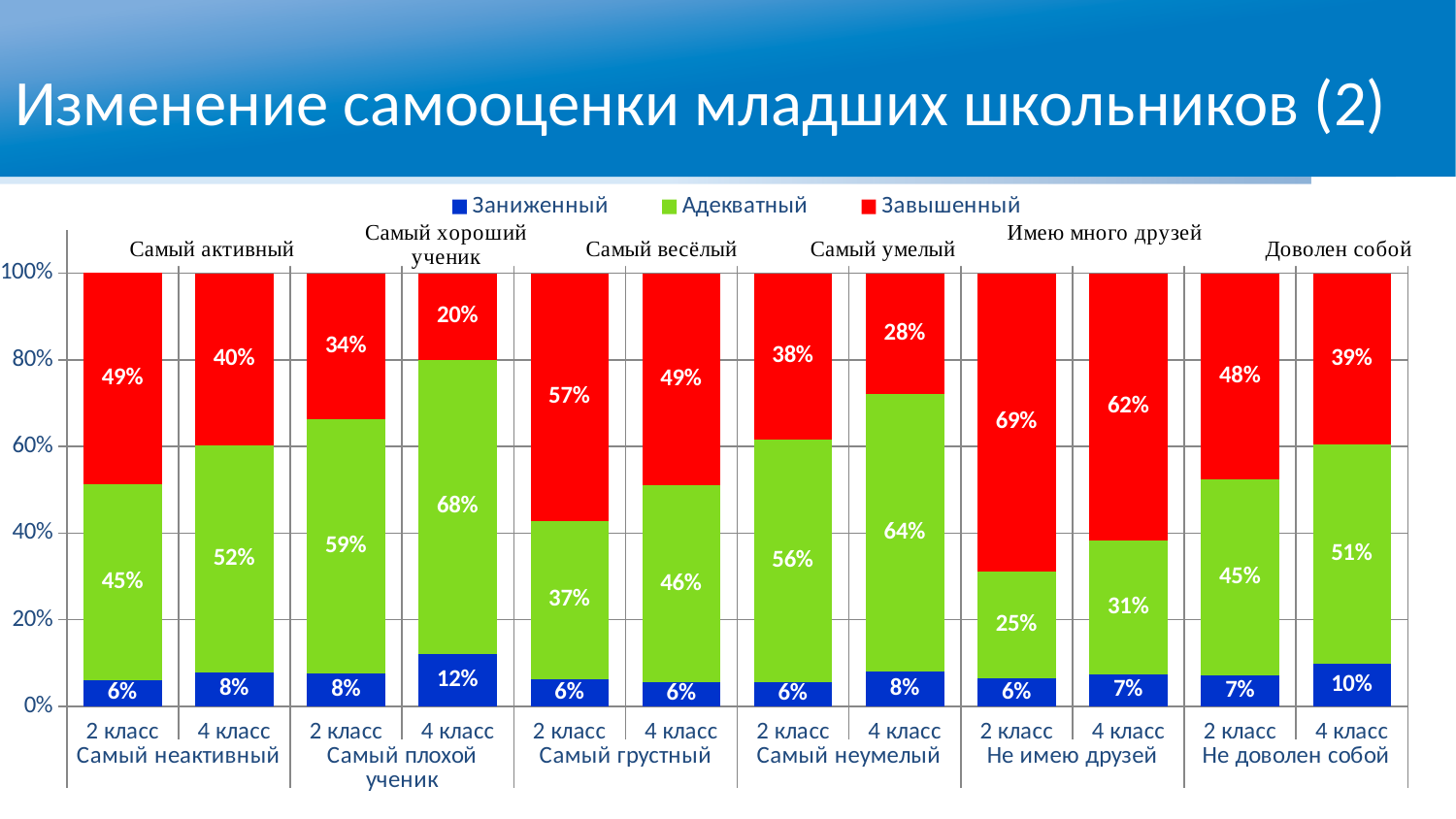
What type of chart is shown on the slide? Stacked bar chart What is the value of Завышенный for 2 класс in the group Не имею друзей? 69% Which bar has the lowest Адекватный value? 2 класс, Не имею друзей (25%) How many series does the legend list? 3 Which is larger: the Адекватный value for 2 класс or for 4 класс in the group Самый грустный? 4 класс (46%) How many bars are plotted in the chart? 12 Which bar has the highest Заниженный value? 4 класс, Самый плохой ученик (12%) Which colour represents the series Адекватный in the legend? Green What is the difference between the Завышенный values for 2 класс and 4 класс in the group Самый плохой ученик? 14% What is the value of Адекватный for 4 класс in the group Самый плохой ученик? 68% What is the value of Заниженный for 4 класс in the group Не доволен собой? 10% Does the Завышенный value fall or rise from 2 класс to 4 класс in the group Самый неумелый? Falls (38% to 28%)